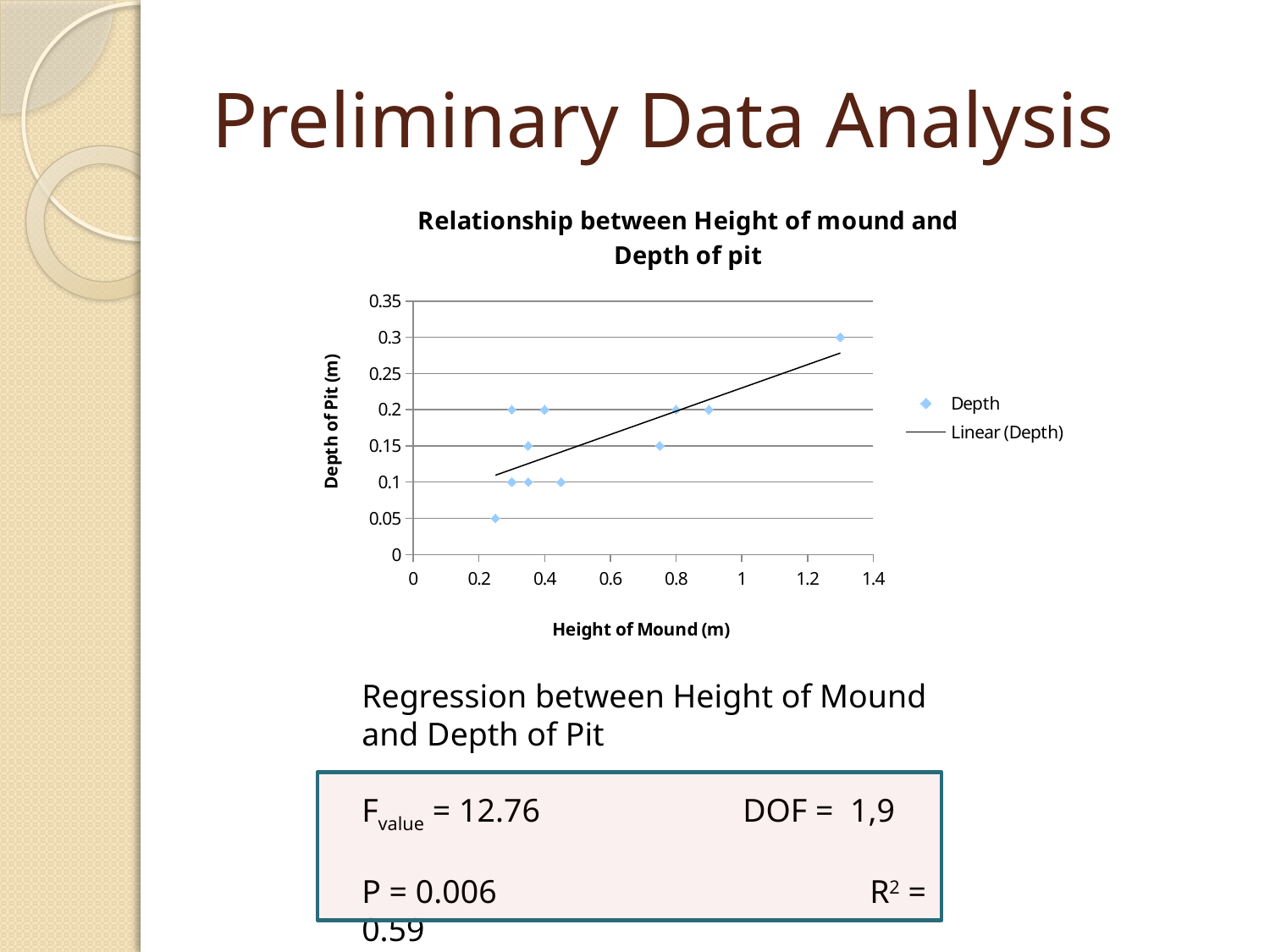
What is the highest Depth of Pit value plotted in the chart? 0.3 What are the two entries in the chart legend? Depth and Linear (Depth) How many data points are plotted in the chart? 11 Is the Depth of Pit for the point with the greatest Height of Mound greater or less than 0.25? greater Does the linear trendline rise or fall as Height of Mound increases? Rises What is the maximum value shown on the Height of Mound axis? 1.4 What is the label of the vertical axis? Depth of Pit (m) What is the lowest Depth of Pit value plotted in the chart? 0.05 How many entries does the chart legend list? 2 What kind of chart is shown on the slide? Scatter chart What is the title of the chart? Relationship between Height of mound and Depth of pit What is the label of the horizontal axis? Height of Mound (m)